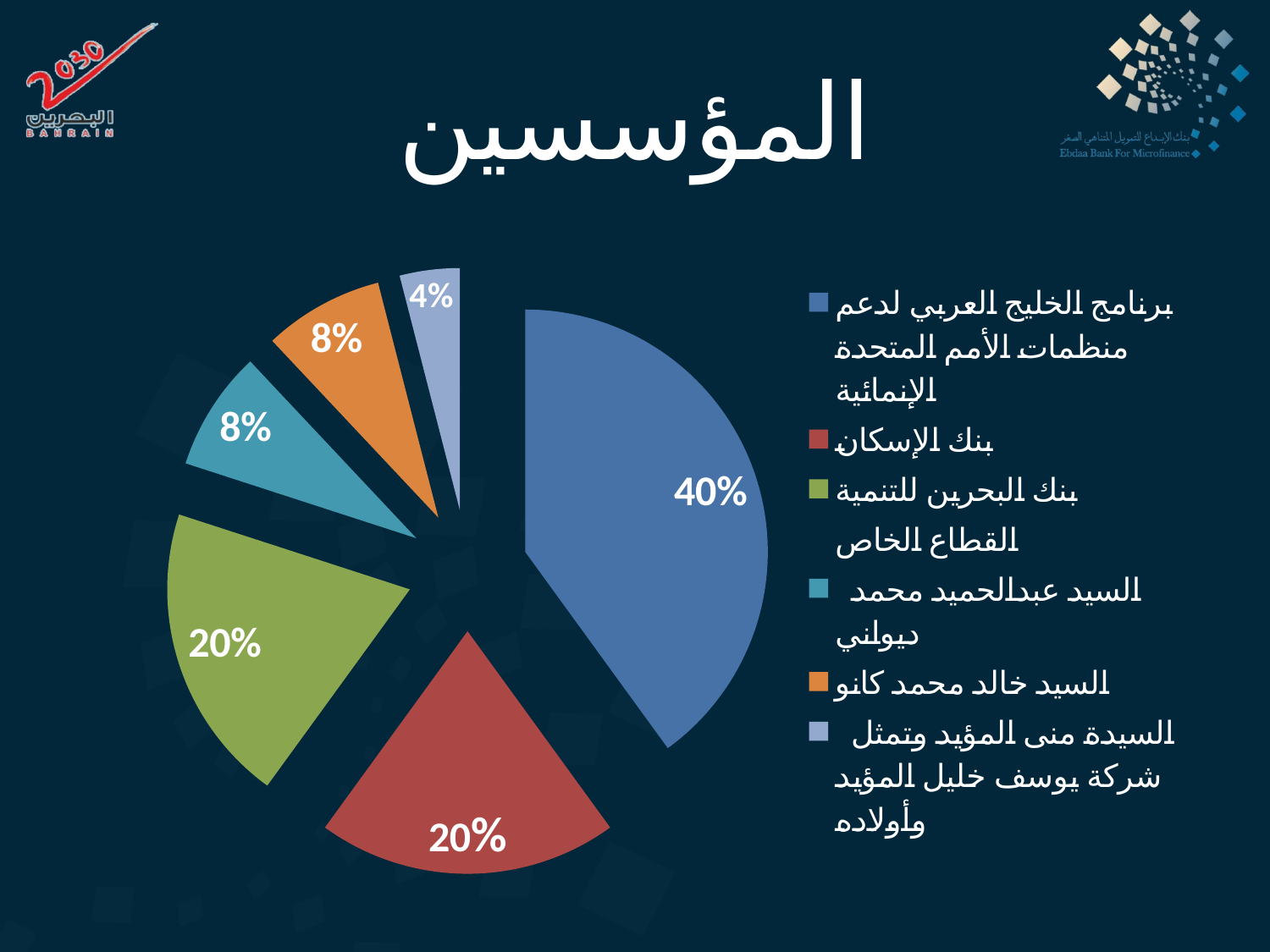
Which is larger, the share of السيد عبدالحميد محمد ديولني or the share of السيدة منى المؤيد وتمثل شركة يوسف خليل المؤيد وأولاده? السيد عبدالحميد محمد ديولني Which founder has the largest share of the pie? برنامج الخليج العربي لدعم منظمات الأمم المتحدة الإنمائية Which founder has the smallest share of the pie? السيدة منى المؤيد وتمثل شركة يوسف خليل المؤيد وأولاده What share of the pie does بنك البحرين للتنمية hold? 20% What share of the pie does بنك الإسكان hold? 20% What is the title of the chart on the slide? المؤسسين What share of the pie does برنامج الخليج العربي لدعم منظمات الأمم المتحدة الإنمائية hold? 40% What is the difference between the share of برنامج الخليج العربي لدعم منظمات الأمم المتحدة الإنمائية and the share of بنك الإسكان? 20% What share of the pie does السيد خالد محمد كانو hold? 8% What kind of chart is shown on the slide? pie chart What share of the pie does السيدة منى المؤيد وتمثل شركة يوسف خليل المؤيد وأولاده hold? 4% How many slices does the pie chart have? 6